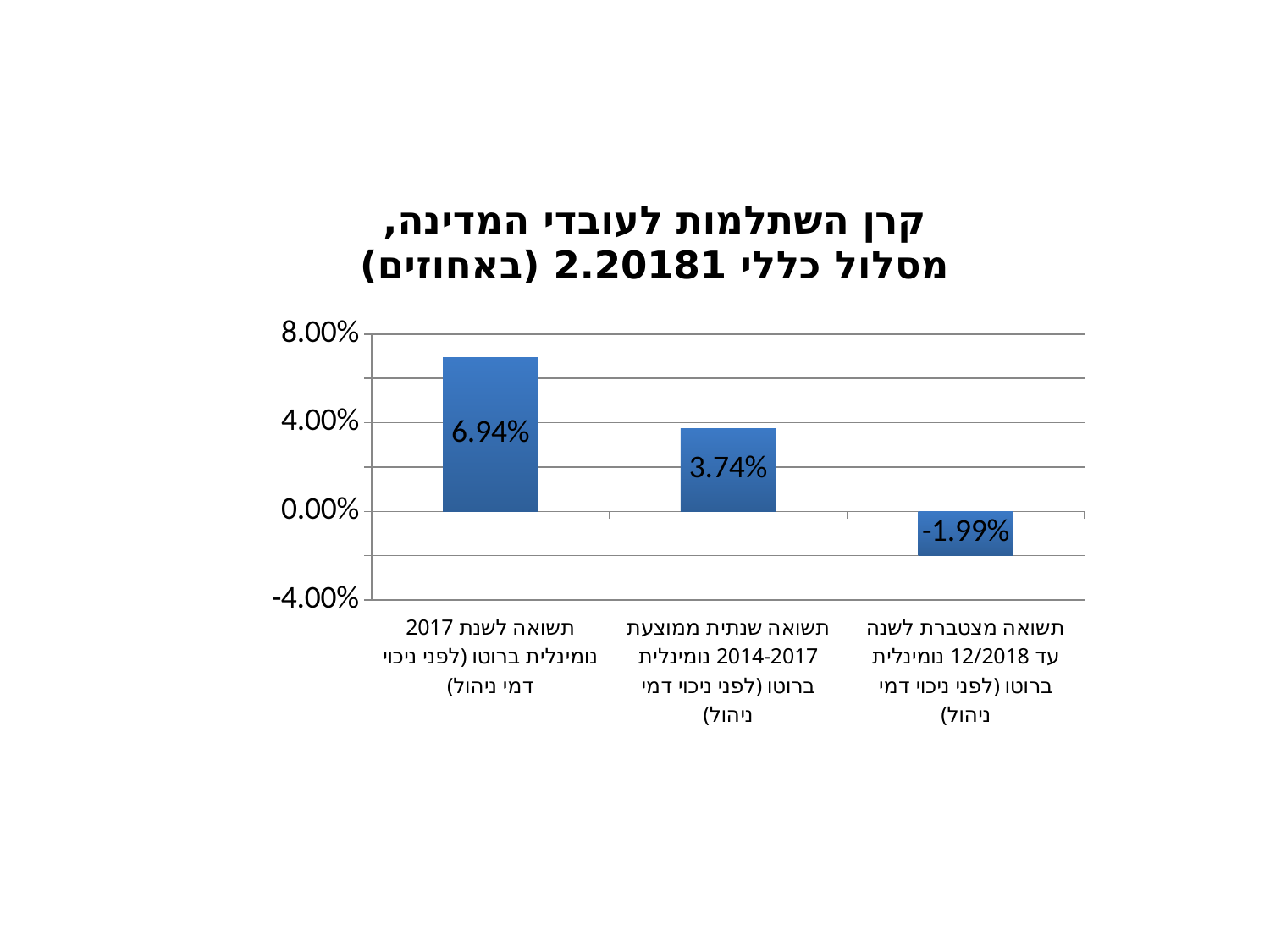
What kind of chart is shown on the slide? Bar chart Which category has the lowest value? תשואה מצטברת לשנה עד 12/2018 נומינלית ברוטו (לפני ניכוי דמי ניהול) What is the value of the bar for 'תשואה לשנת 2017 נומינלית ברוטו (לפני ניכוי דמי ניהול)'? 6.94% What is the value of the bar for 'תשואה שנתית ממוצעת 2014-2017 נומינלית ברוטו (לפני ניכוי דמי ניהול)'? 3.74% How many categories (bars) are shown in the chart? 3 Is the value for the 2017 return greater or less than 4.00%? greater What is the difference between the 2017 return (6.94%) and the 2014-2017 average annual return (3.74%)? 3.20% Which category has the highest value? תשואה לשנת 2017 נומינלית ברוטו (לפני ניכוי דמי ניהול) Is the value for the cumulative return to 12/2018 greater or less than 0.00%? less Which is larger: the return for 2017 or the average annual return for 2014-2017? The return for 2017 (6.94%) What is the title of the chart? קרן השתלמות לעובדי המדינה, מסלול כללי 2.20181 (באחוזים) What is the value of the bar for 'תשואה מצטברת לשנה עד 12/2018 נומינלית ברוטו (לפני ניכוי דמי ניהול)'? -1.99%